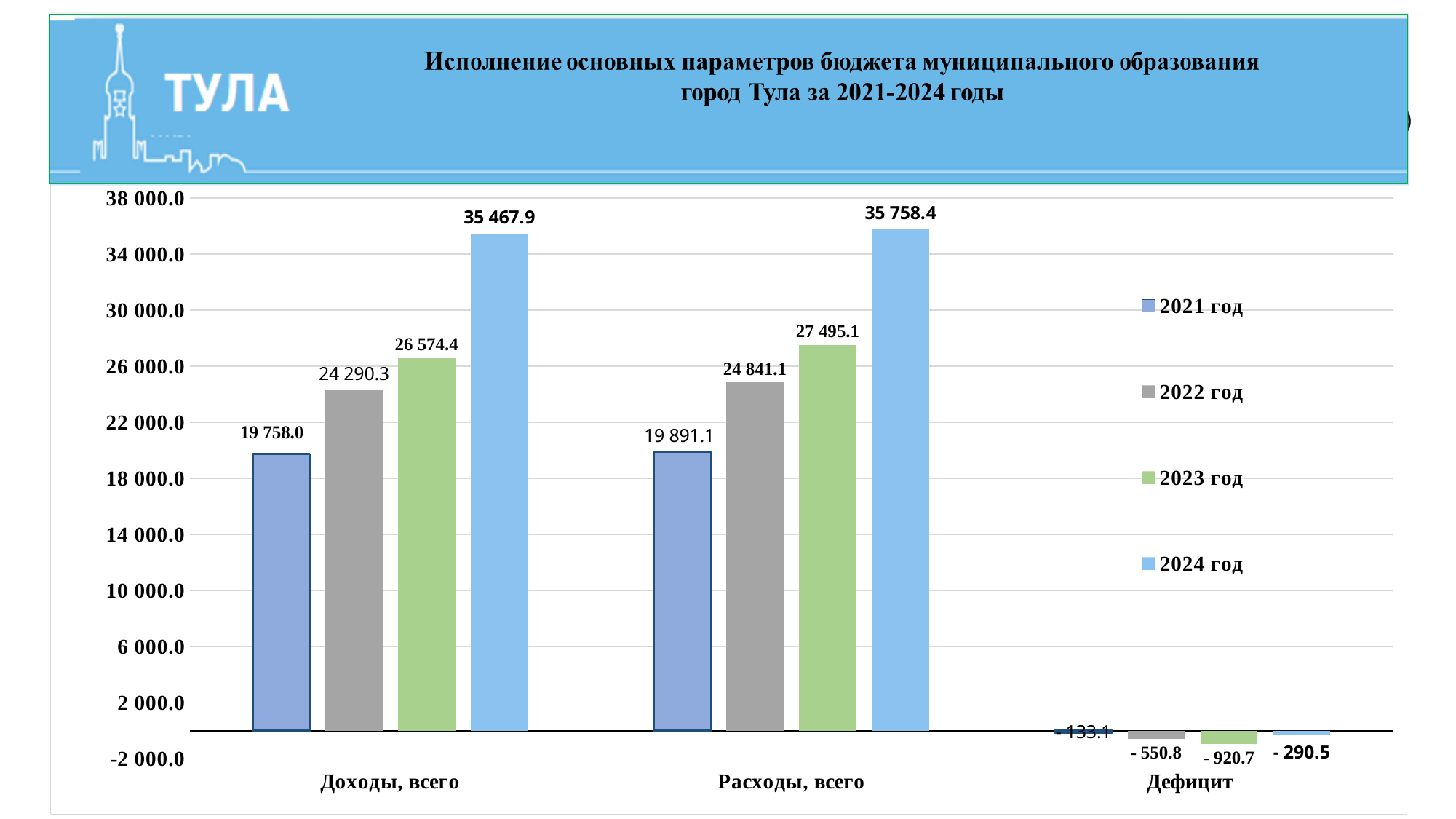
Which year has the highest value in the Расходы, всего category? 2024 год Is the 2022 год value for Доходы, всего greater or less than 26 000.0? less What is the value for 2023 год in the Дефицит category? - 920.7 What is the value for 2021 год in the Доходы, всего category? 19 758.0 How many categories are shown on the x axis? 3 What is the difference between the 2024 год values for Расходы, всего and Доходы, всего? 290.5 Which year has the lowest value in the Доходы, всего category? 2021 год What is the value for 2024 год in the Доходы, всего category? 35 467.9 What is the value for 2022 год in the Расходы, всего category? 24 841.1 How many series does the legend list? 4 Which is larger: the 2023 год value for Доходы, всего or the 2023 год value for Расходы, всего? Расходы, всего What kind of chart is shown on the slide? bar chart